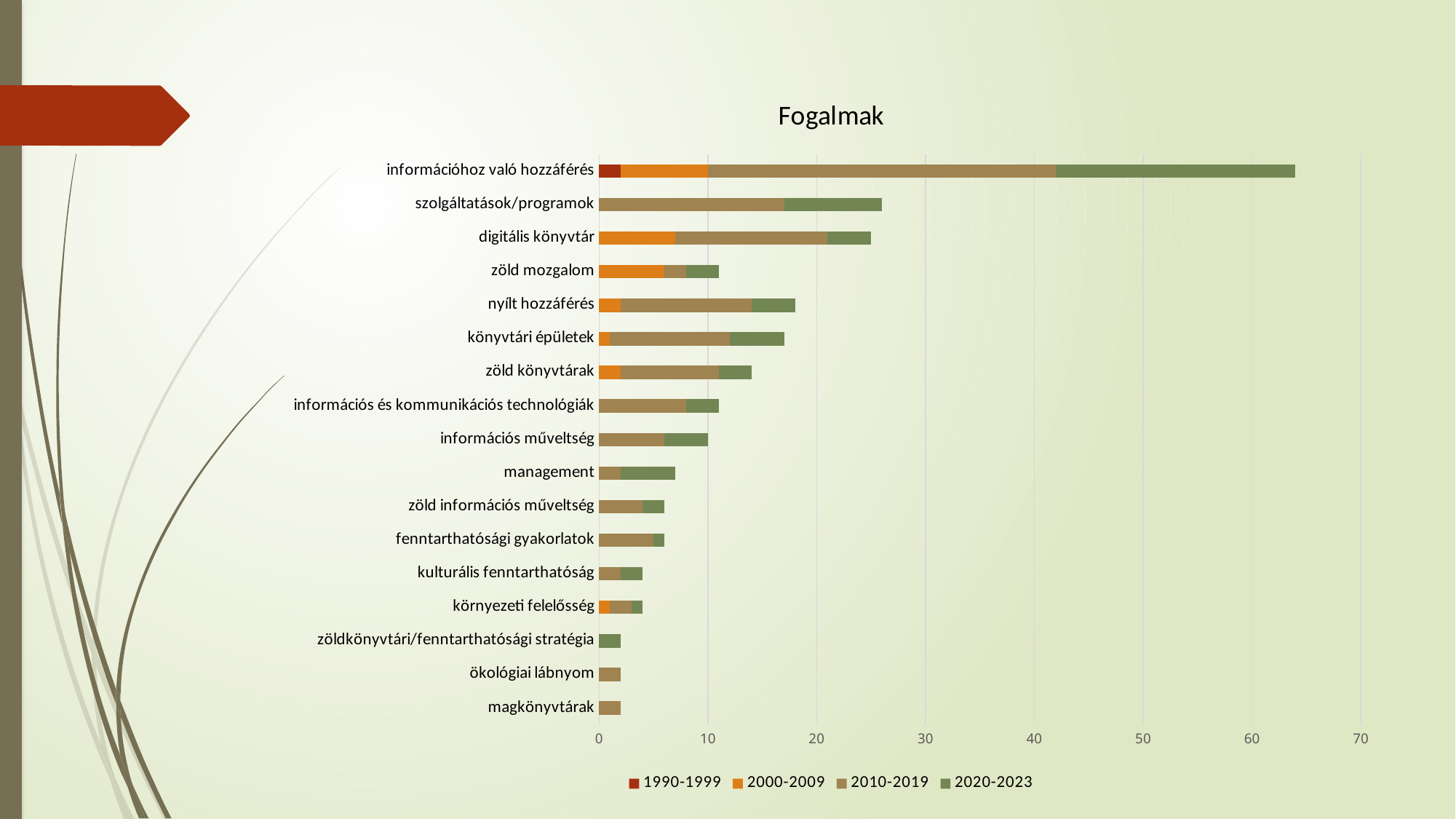
Is the total value for szolgáltatások/programok greater or less than 20? greater Is the total value for nyílt hozzáférés greater or less than 20? less Which category is the only one with a 1990-1999 segment? információhoz való hozzáférés How many categories are plotted on the chart? 17 Is the total value for management greater or less than 10? less How many series does the legend list? 4 Which has the larger total bar, nyílt hozzáférés or zöld könyvtárak? nyílt hozzáférés What is the title of the chart? Fogalmak Which category has the longest bar overall? információhoz való hozzáférés Which has the larger total bar, szolgáltatások/programok or zöld mozgalom? szolgáltatások/programok What kind of chart is shown on the slide? Stacked bar chart